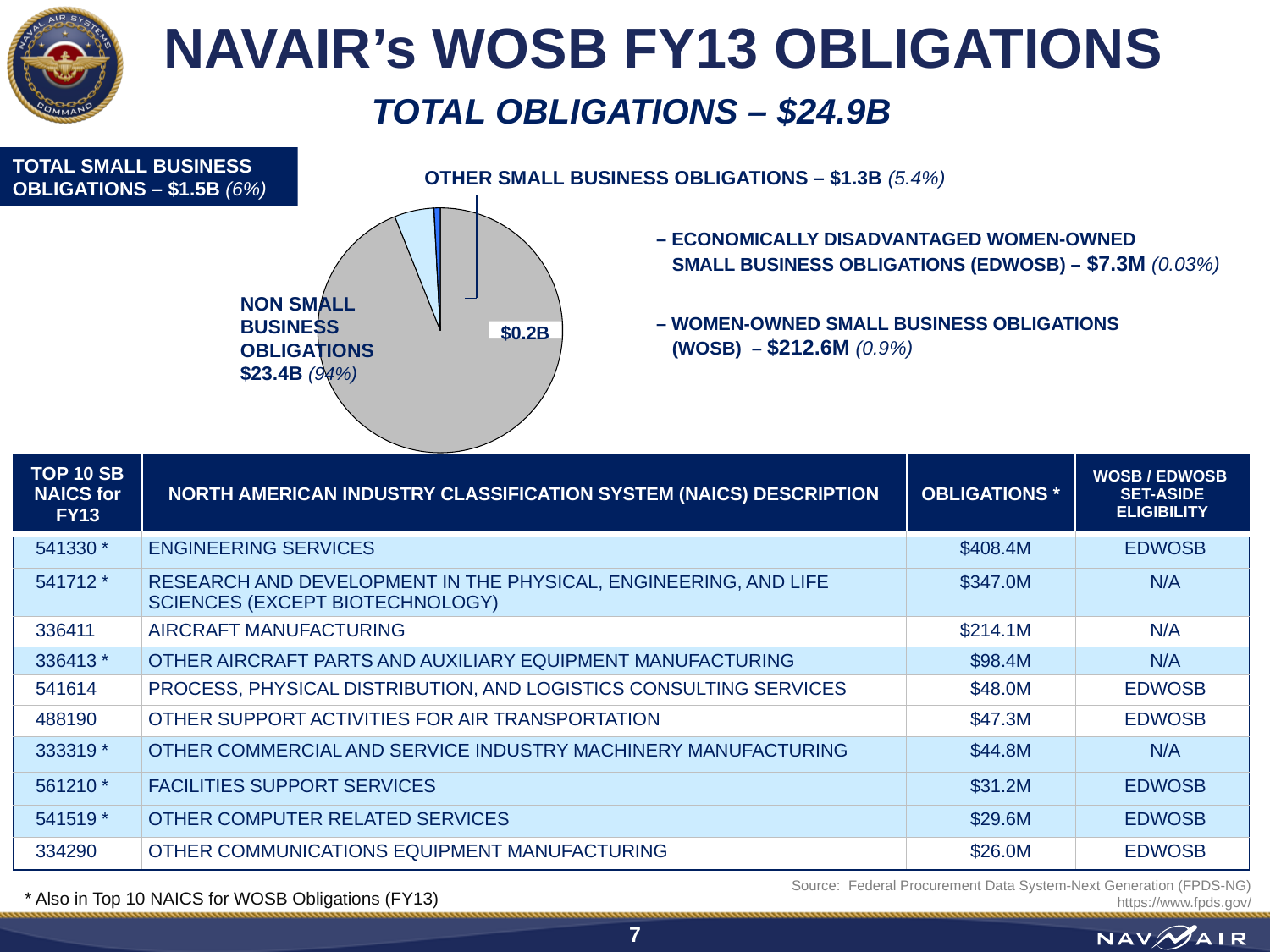
What is the difference between Non Small Business Obligations and Other Small Business Obligations? $22.1B Which is larger, WOSB obligations or EDWOSB obligations? WOSB What is the value of Women-Owned Small Business Obligations (WOSB)? $212.6M Which category has the smallest share of the pie chart? EDWOSB What data label is printed on the pie chart itself? $0.2B Which category has the largest slice of the pie chart? Non Small Business Obligations What share of the pie do Non Small Business Obligations represent? 94% What is the value of Other Small Business Obligations? $1.3B What is the value of Non Small Business Obligations in the pie chart? $23.4B What share of the pie do Other Small Business Obligations represent? 5.4% What kind of chart is shown on the slide? pie chart What is the value of Economically Disadvantaged Women-Owned Small Business Obligations (EDWOSB)? $7.3M